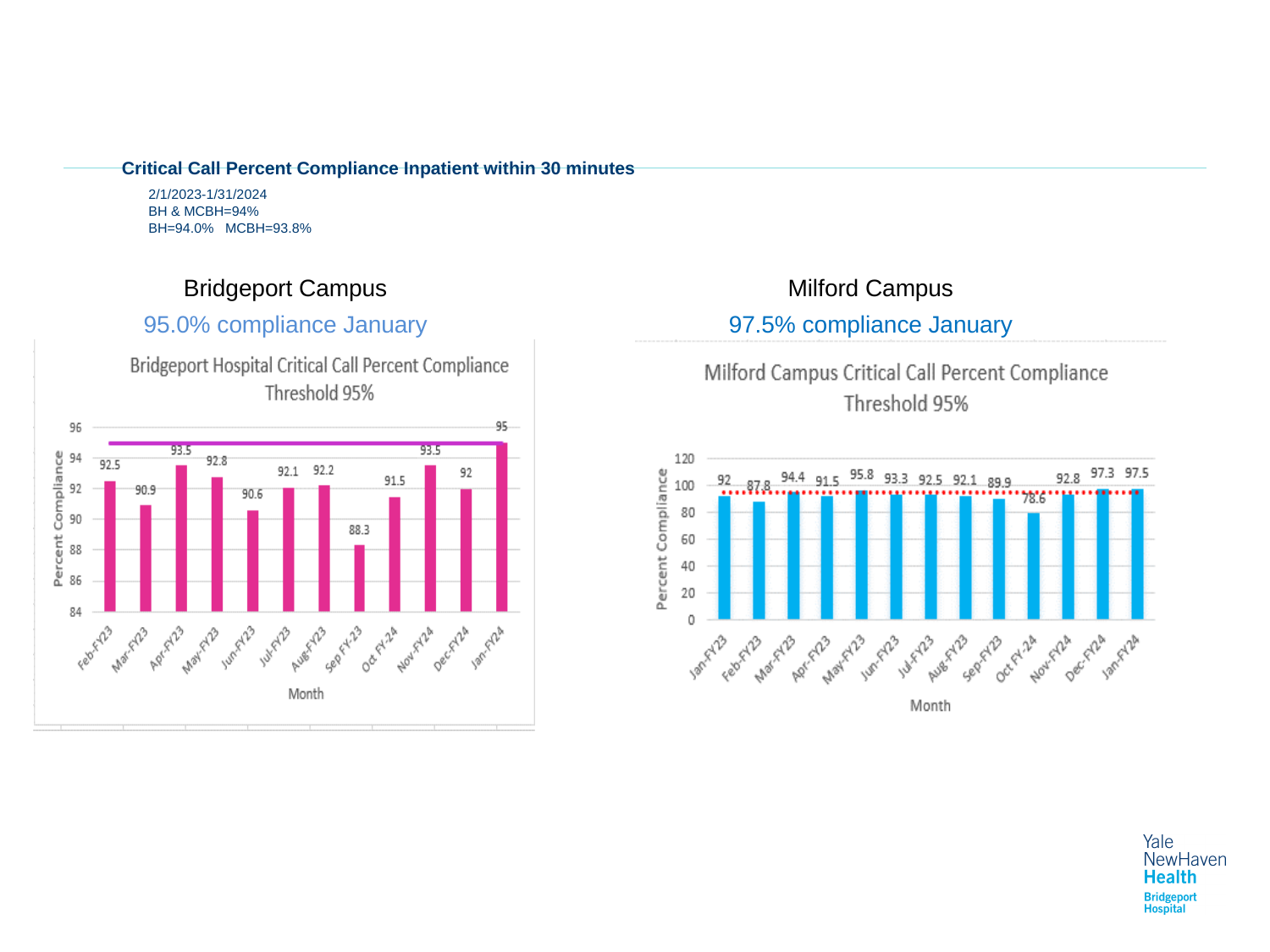
In the Bridgeport Hospital chart, which month has the lowest percent compliance? Sep-FY23 In the Milford Campus chart, what is the difference between the Jan-FY24 value and the Jan-FY23 value? 5.5 What type of chart is the Milford Campus chart? Bar chart How many months are plotted in the Bridgeport Hospital chart? 12 In the Bridgeport Hospital chart, what is the difference between the Jan-FY24 value and the Sep-FY23 value? 6.7 In the Bridgeport Hospital chart, what is the percent compliance for Sep-FY23? 88.3 In the Bridgeport Hospital chart, which month has the highest percent compliance? Jan-FY24 In the Bridgeport Hospital chart, which is larger, the value for Apr-FY23 or the value for Jun-FY23? Apr-FY23 In the Milford Campus chart, what is the percent compliance for Oct FY-24? 78.6 How many months are plotted in the Milford Campus chart? 13 In the Milford Campus chart, which month has the lowest percent compliance? Oct FY-24 In the Milford Campus chart, which month has the highest percent compliance? Jan-FY24